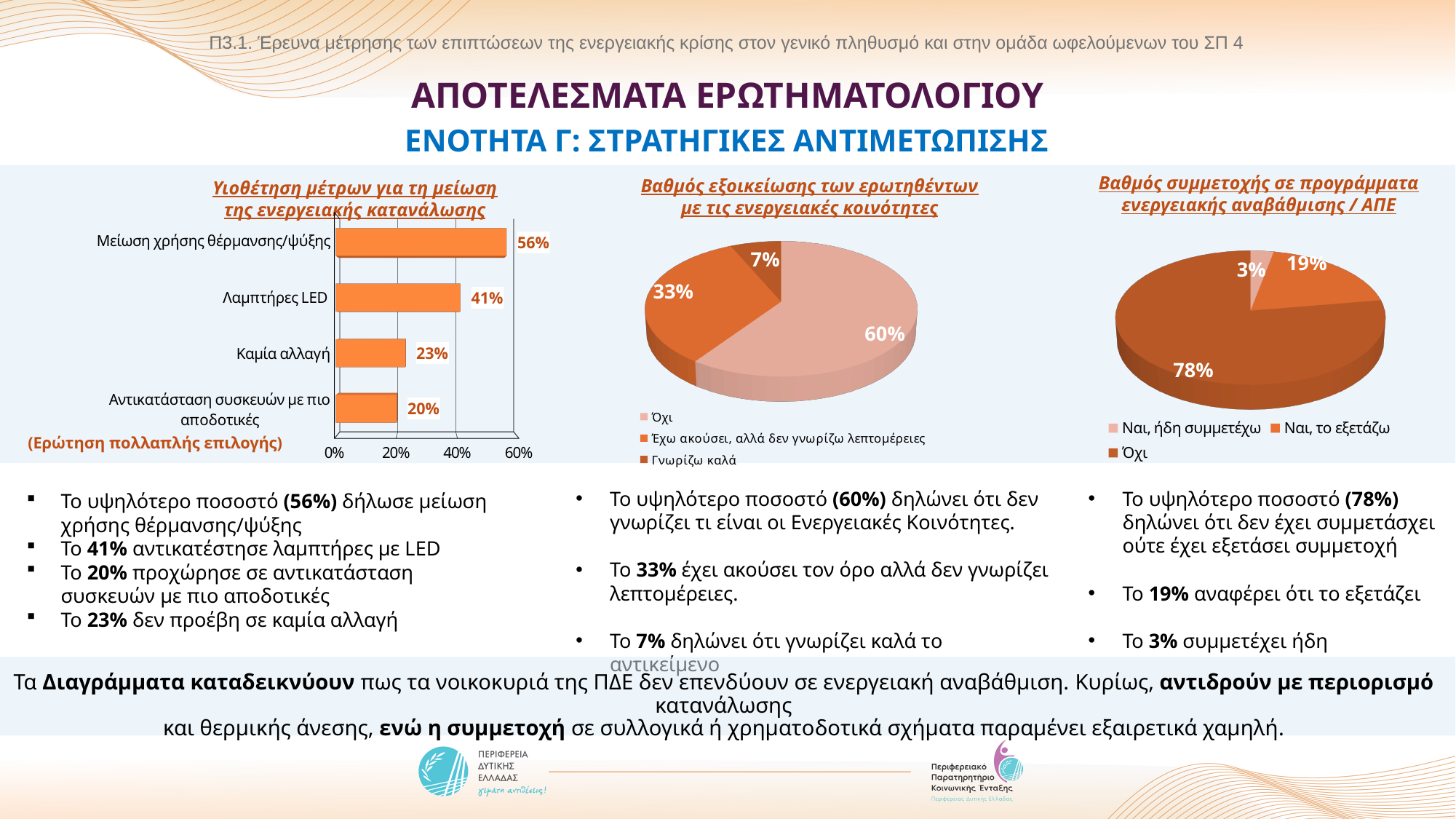
In the right pie chart 'Βαθμός συμμετοχής σε προγράμματα ενεργειακής αναβάθμισης / ΑΠΕ', which slice is the smallest? Ναι, ήδη συμμετέχω In the left chart 'Υιοθέτηση μέτρων για τη μείωση της ενεργειακής κατανάλωσης', what is the value for 'Λαμπτήρες LED'? 41% What type of chart is the left chart 'Υιοθέτηση μέτρων για τη μείωση της ενεργειακής κατανάλωσης'? Bar chart In the left chart 'Υιοθέτηση μέτρων για τη μείωση της ενεργειακής κατανάλωσης', which category has the highest value? Μείωση χρήσης θέρμανσης/ψύξης In the middle pie chart 'Βαθμός εξοικείωσης των ερωτηθέντων με τις ενεργειακές κοινότητες', which slice is the largest? Όχι In the middle pie chart 'Βαθμός εξοικείωσης των ερωτηθέντων με τις ενεργειακές κοινότητες', how many slices does the legend list? 3 In the left chart 'Υιοθέτηση μέτρων για τη μείωση της ενεργειακής κατανάλωσης', which category has the lowest value? Αντικατάσταση συσκευών με πιο αποδοτικές In the middle pie chart 'Βαθμός εξοικείωσης των ερωτηθέντων με τις ενεργειακές κοινότητες', what share does 'Γνωρίζω καλά' have? 7% In the right pie chart 'Βαθμός συμμετοχής σε προγράμματα ενεργειακής αναβάθμισης / ΑΠΕ', what share does 'Ναι, το εξετάζω' have? 19% In the right pie chart 'Βαθμός συμμετοχής σε προγράμματα ενεργειακής αναβάθμισης / ΑΠΕ', which is larger: 'Όχι' or 'Ναι, το εξετάζω'? Όχι In the left chart 'Υιοθέτηση μέτρων για τη μείωση της ενεργειακής κατανάλωσης', how many categories are shown? 4 In the left chart 'Υιοθέτηση μέτρων για τη μείωση της ενεργειακής κατανάλωσης', what is the difference between 'Μείωση χρήσης θέρμανσης/ψύξης' and 'Καμία αλλαγή'? 33%